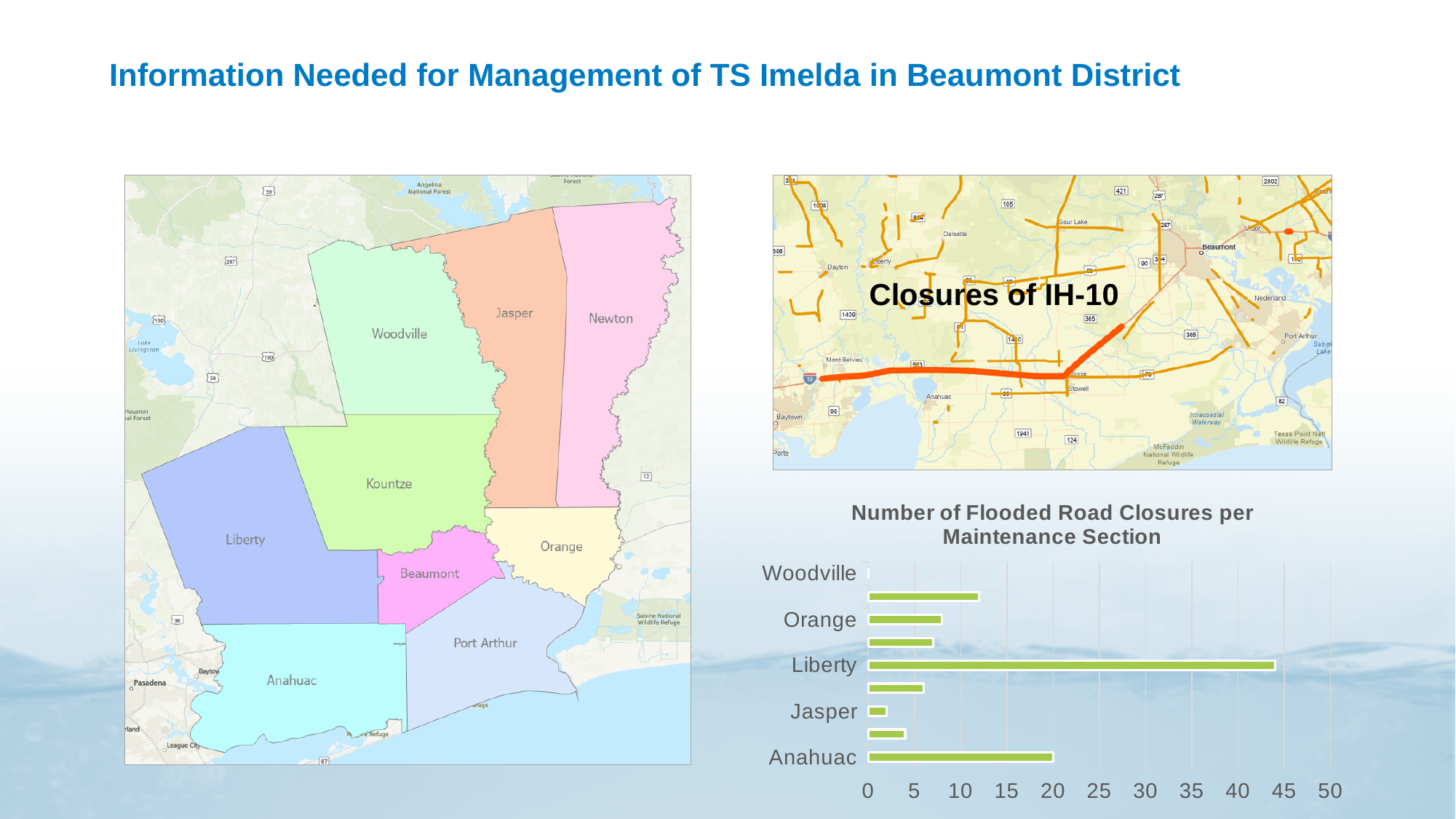
In the 'Number of Flooded Road Closures per Maintenance Section' chart, is the value for Liberty greater or less than 40? greater What is the highest value shown on the horizontal axis of the 'Number of Flooded Road Closures per Maintenance Section' chart? 50 In the 'Number of Flooded Road Closures per Maintenance Section' chart, which has more closures, Orange or Jasper? Orange In the 'Number of Flooded Road Closures per Maintenance Section' chart, is the value for Jasper greater or less than 5? less In the 'Number of Flooded Road Closures per Maintenance Section' chart, which has more closures, Anahuac or Orange? Anahuac In the 'Number of Flooded Road Closures per Maintenance Section' chart, which labeled maintenance section has the highest number of closures? Liberty In the 'Number of Flooded Road Closures per Maintenance Section' chart, is the value for Anahuac greater or less than 15? greater What kind of chart is the 'Number of Flooded Road Closures per Maintenance Section' chart? bar chart In the 'Number of Flooded Road Closures per Maintenance Section' chart, which has more closures, Liberty or Anahuac? Liberty